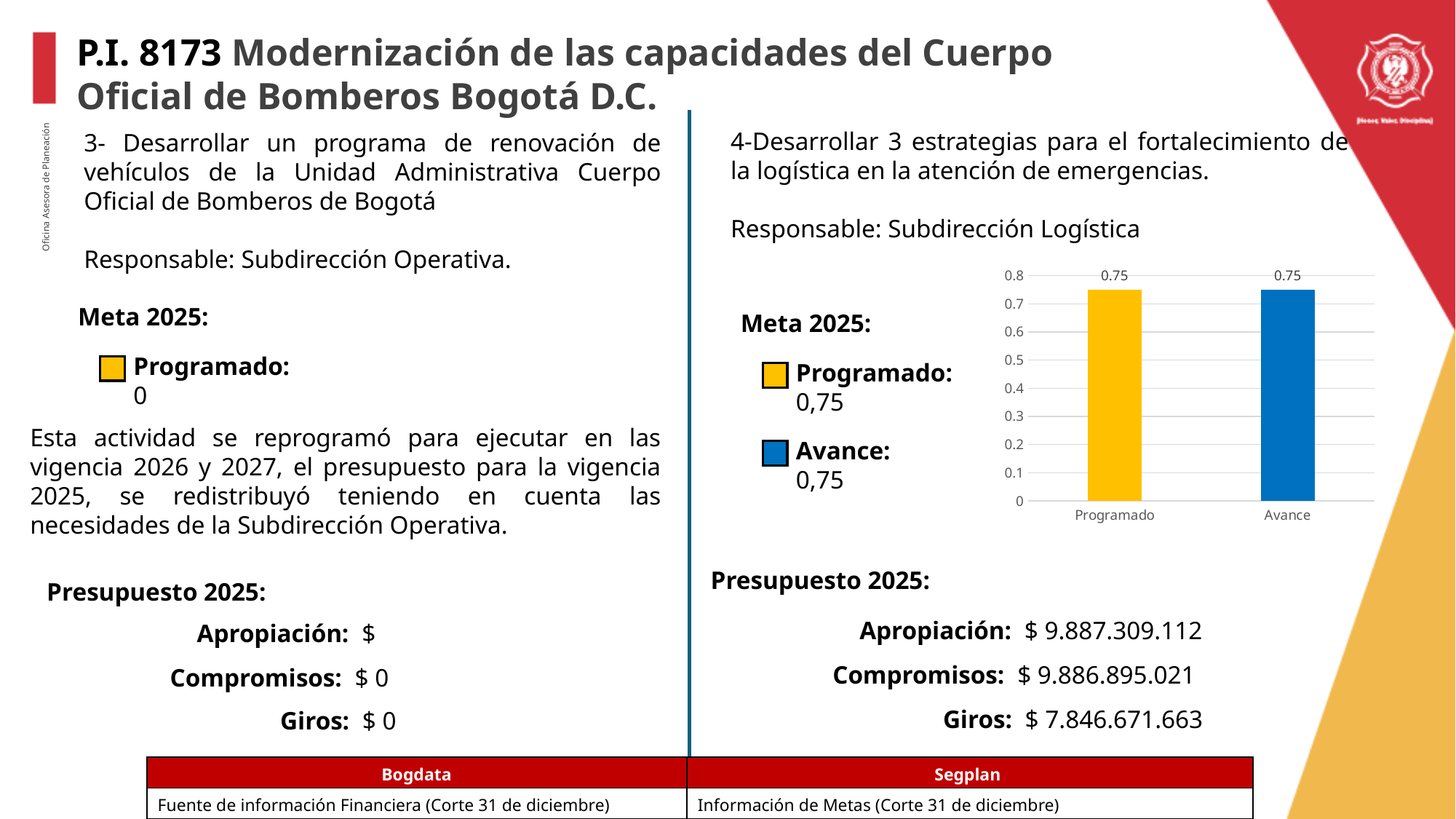
What colour is the Avance bar in the chart? blue How many bars are plotted in the chart? 2 What is the difference between the Programado and Avance values in the chart? 0 What are the two category labels on the x axis of the chart? Programado and Avance What type of chart is shown on the slide? bar chart Is the value for Programado greater or less than 0.8? less What is the highest tick value shown on the chart's y axis? 0.8 What is the value of the Programado bar in the chart? 0.75 Is the value for Avance greater or less than 0.5? greater What is the value of the Avance bar in the chart? 0.75